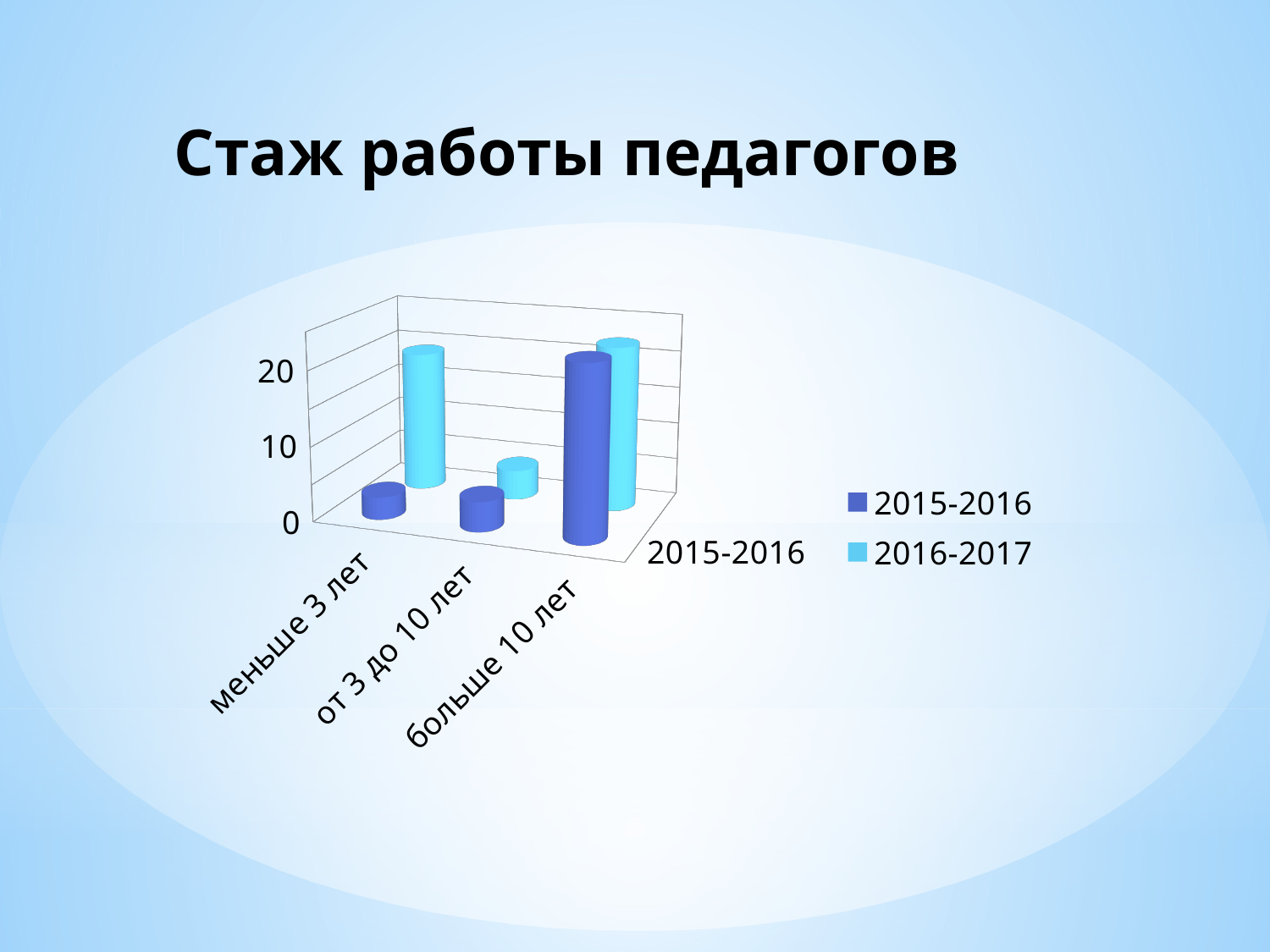
What kind of chart is shown on the slide? bar chart Is the value for 'от 3 до 10 лет' in the 2016-2017 series greater or less than 10? less Which category has the highest value in the 2015-2016 series? больше 10 лет Is the value for 'меньше 3 лет' in the 2016-2017 series greater or less than 10? greater How many series does the legend list? 2 Which series is shown in light blue in the legend? 2016-2017 Is the value for 'больше 10 лет' in the 2015-2016 series greater or less than 10? greater For 'меньше 3 лет', which series has the larger value, 2015-2016 or 2016-2017? 2016-2017 Which category has the lowest value in the 2016-2017 series? от 3 до 10 лет What is the title of the chart? Стаж работы педагогов How many categories are shown on the category axis? 3